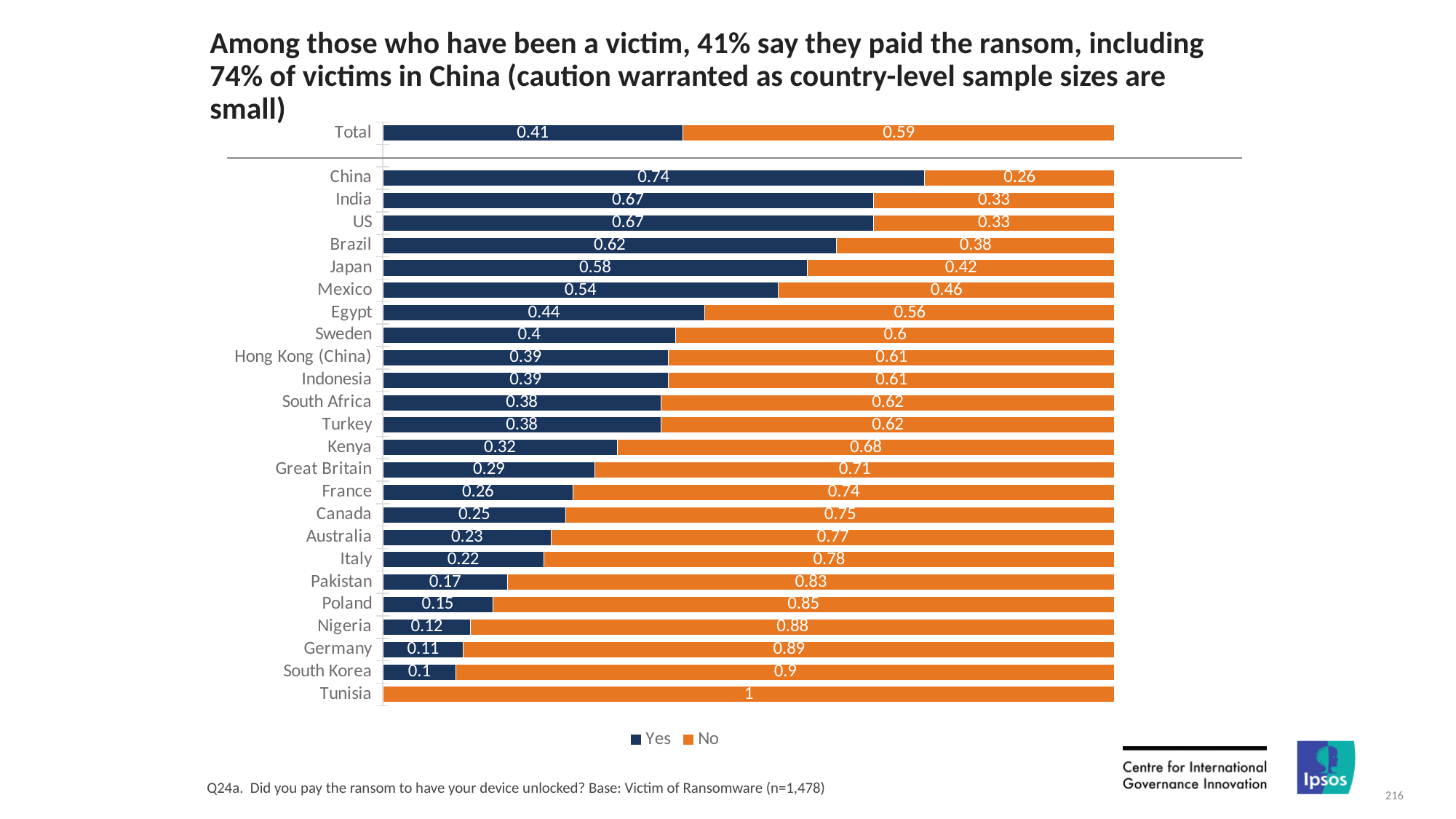
What is the "Yes" value for China? 0.74 What is the difference between the "Yes" values for China and Germany? 0.63 What is the total of the stacked bar for Kenya? 1 Which has a larger "Yes" value, Brazil or Mexico? Brazil Which country has the lowest "Yes" value? Tunisia What is the "No" value for Sweden? 0.6 Which country has the highest "Yes" value? China Which colour represents the "No" series? Orange What kind of chart is shown on the slide? Stacked bar chart How many series does the legend list? 2 What is the "Yes" value for Total? 0.41 What is the "No" value for Tunisia? 1